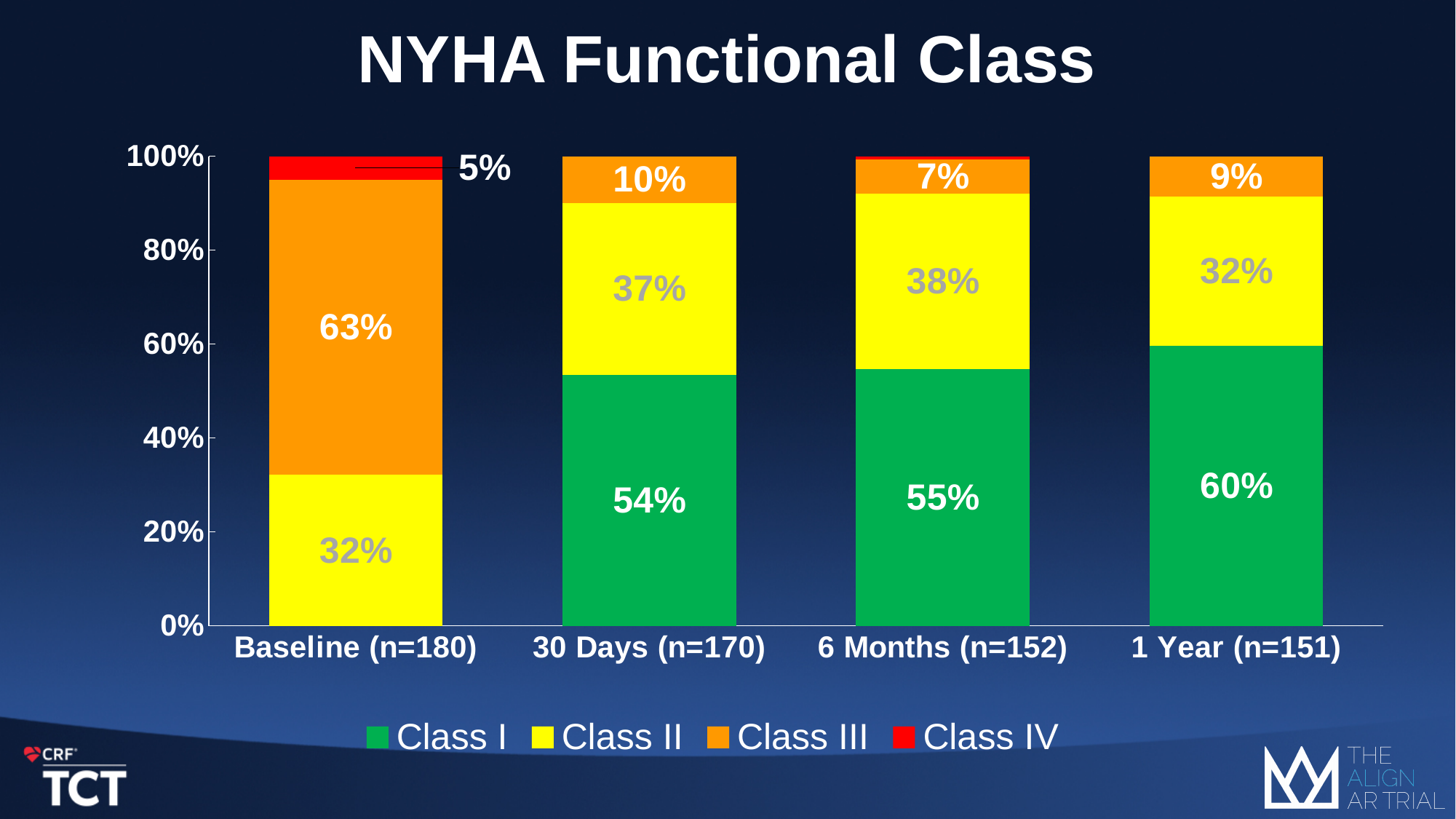
How many series does the legend list? 4 Does the Class I share rise or fall from 30 Days to 1 Year? Rise How many time points are shown on the x axis? 4 Which is larger: the Class II share at 30 Days or the Class II share at 1 Year? Class II at 30 Days What percentage of patients were in Class IV at Baseline? 5% At which time point is the Class III share lowest? 6 Months (n=152) What percentage of patients were in Class III at Baseline? 63% At which time point is the Class I share highest? 1 Year (n=151) What is the difference between the Class I share at 1 Year and at 30 Days? 6% What type of chart is shown on the slide? Stacked bar chart What percentage of patients were in Class I at 1 Year? 60% What percentage of patients were in Class II at 6 Months? 38%